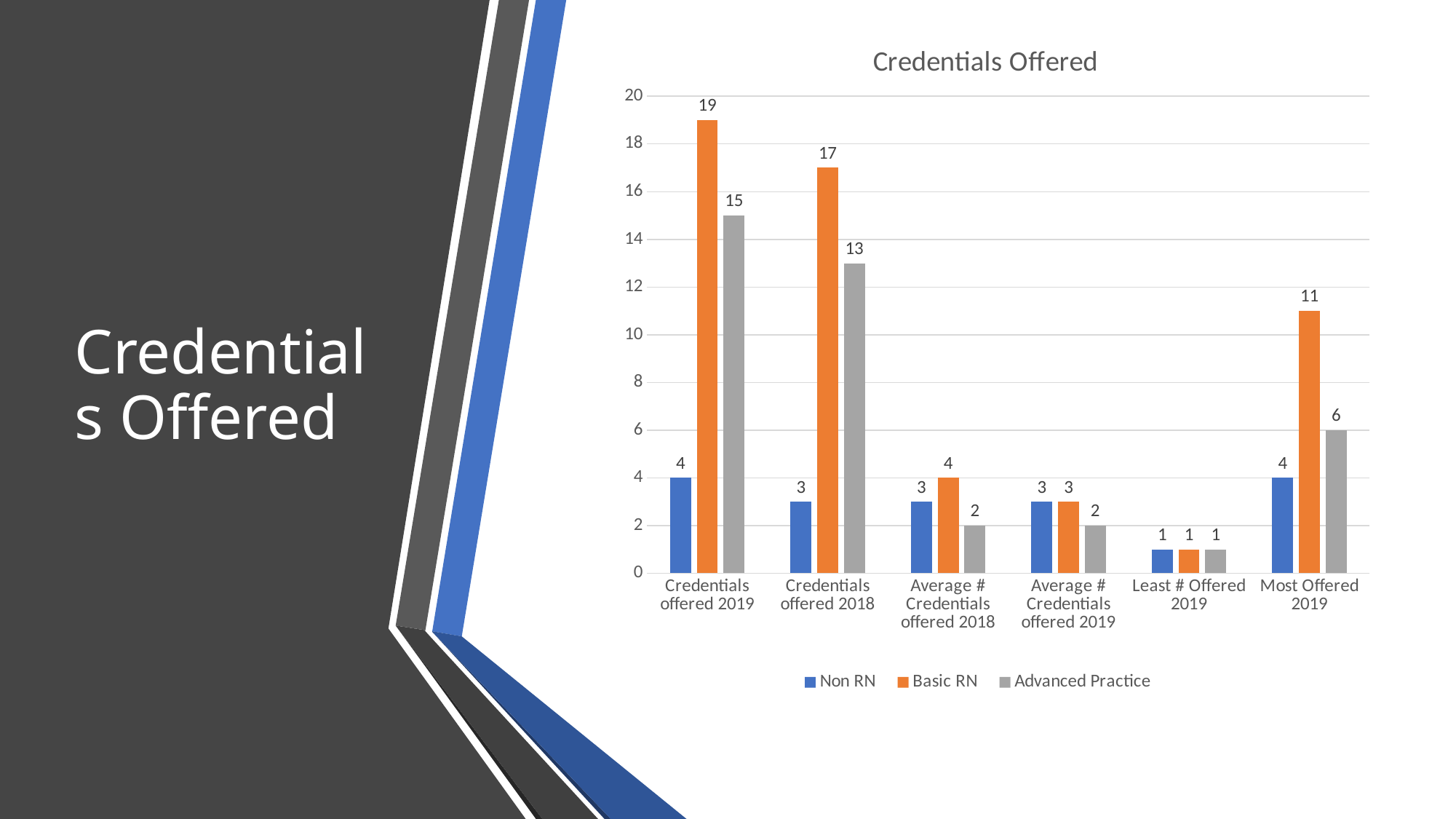
Which category has the lowest Advanced Practice value? Least # Offered 2019 What is the title of the chart? Credentials Offered Which category has the highest Basic RN value? Credentials offered 2019 What is the Non RN value for Most Offered 2019? 4 How many categories are shown on the x axis? 6 What is the difference between the Basic RN values for Credentials offered 2019 and Credentials offered 2018? 2 What is the Basic RN value for Credentials offered 2019? 19 What is the difference between the Basic RN and Advanced Practice values for Credentials offered 2019? 4 What kind of chart is shown on the slide? Bar chart What is the Advanced Practice value for Credentials offered 2018? 13 How many series does the legend list? 3 Which is larger for Most Offered 2019: the Basic RN value or the Advanced Practice value? Basic RN